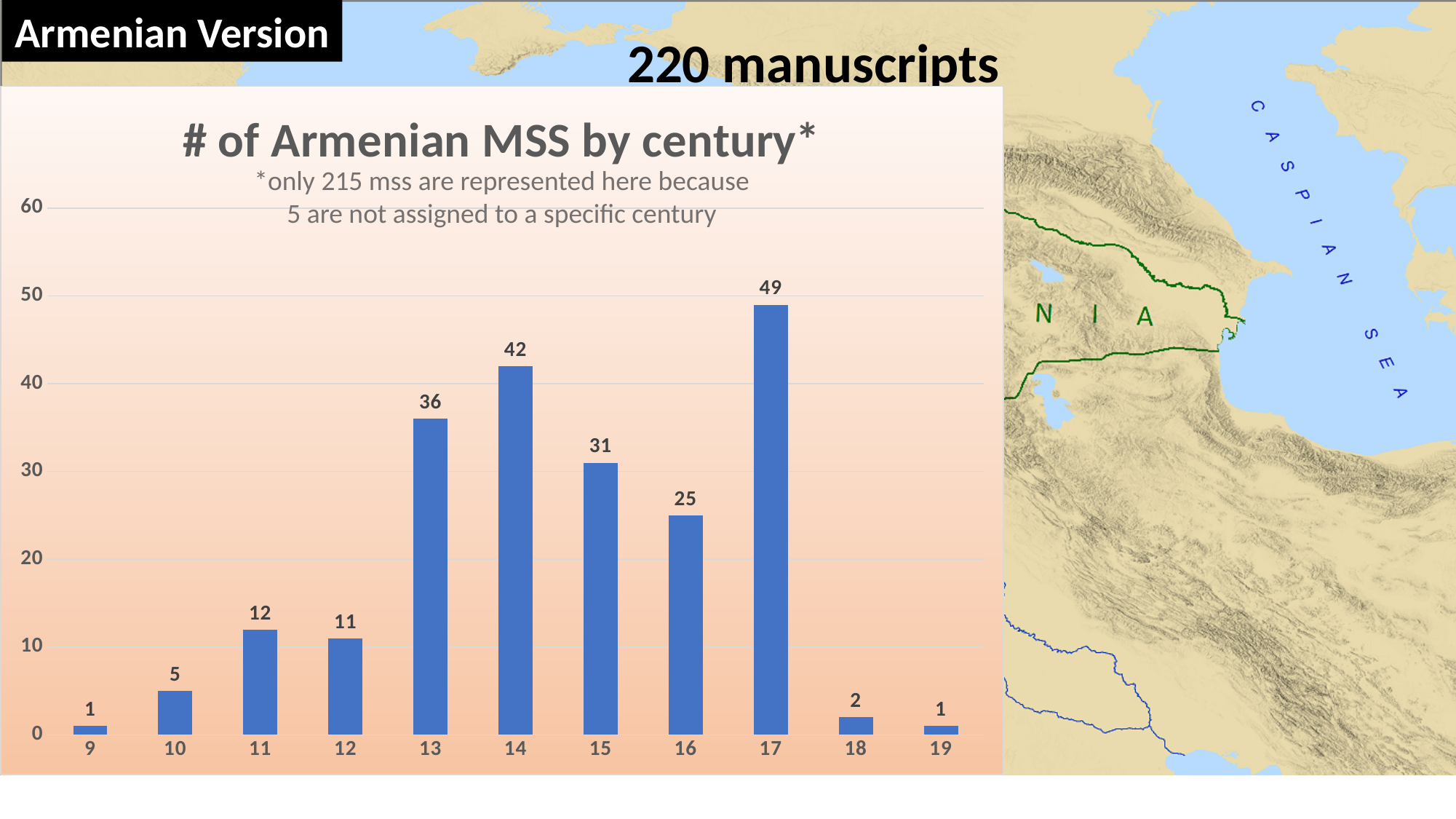
What is the difference between the values for century 17 and century 14? 7 How many centuries are shown on the x axis? 11 What kind of chart is this? bar chart What is the title of the chart? # of Armenian MSS by century* Which century has the highest number of manuscripts? 17 What is the value of the tallest bar? 49 Which has more manuscripts, century 13 or century 15? 13 Do the values rise or fall from century 17 to century 19? fall Is the value for century 15 greater or less than 30? greater How many Armenian manuscripts are shown for the 14th century? 42 What is the difference between the values for century 11 and century 12? 1 What is the value for century 16? 25